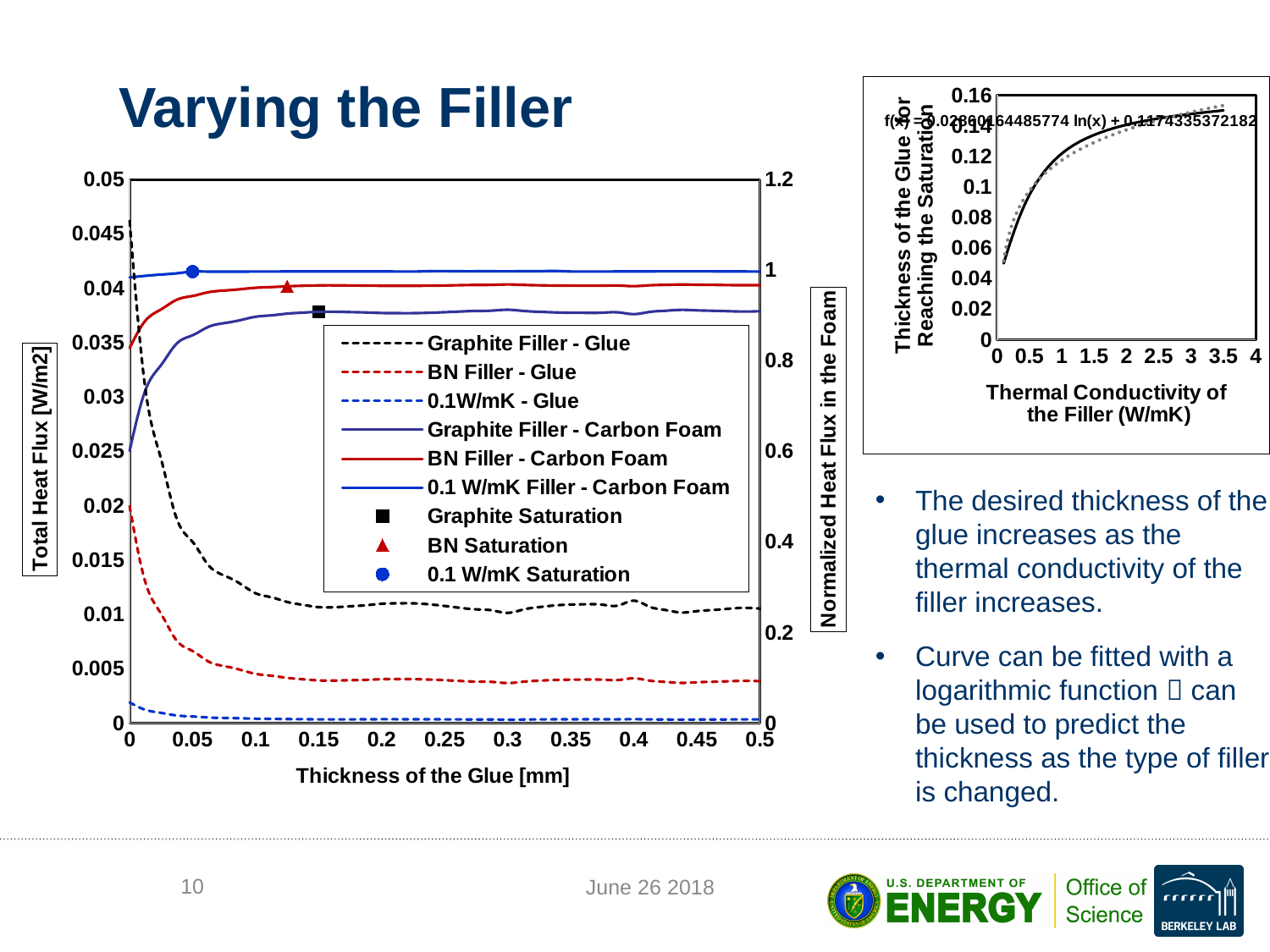
What is the x-axis label of the left chart? Thickness of the Glue [mm] In the left chart, at a thickness of 0.2 mm, which is higher: Graphite Filler - Glue or BN Filler - Glue? Graphite Filler - Glue What kind of chart is the small chart in the top right of the slide? line chart In the left chart, does the Graphite Filler - Glue series rise or fall as the thickness of the glue increases? fall In the top-right chart, does the thickness of the glue for reaching saturation rise or fall as the thermal conductivity of the filler increases? rise In the left chart, is the Graphite Filler - Glue value at a thickness of 0.3 mm greater or less than 0.02? less In the left chart, is the 0.1 W/mK Filler - Carbon Foam value at a thickness of 0.3 mm greater or less than 0.035? greater In the left chart, at a thickness of 0.4 mm, which is higher: BN Filler - Carbon Foam or Graphite Filler - Carbon Foam? BN Filler - Carbon Foam In the left chart, does the Graphite Filler - Carbon Foam series rise or fall as the thickness of the glue increases? rise In the top-right chart, is the value at a thermal conductivity of 3.5 W/mK greater or less than 0.12? greater What kind of chart is the large chart on the left of the slide? line chart How many entries does the legend of the left chart list? 9